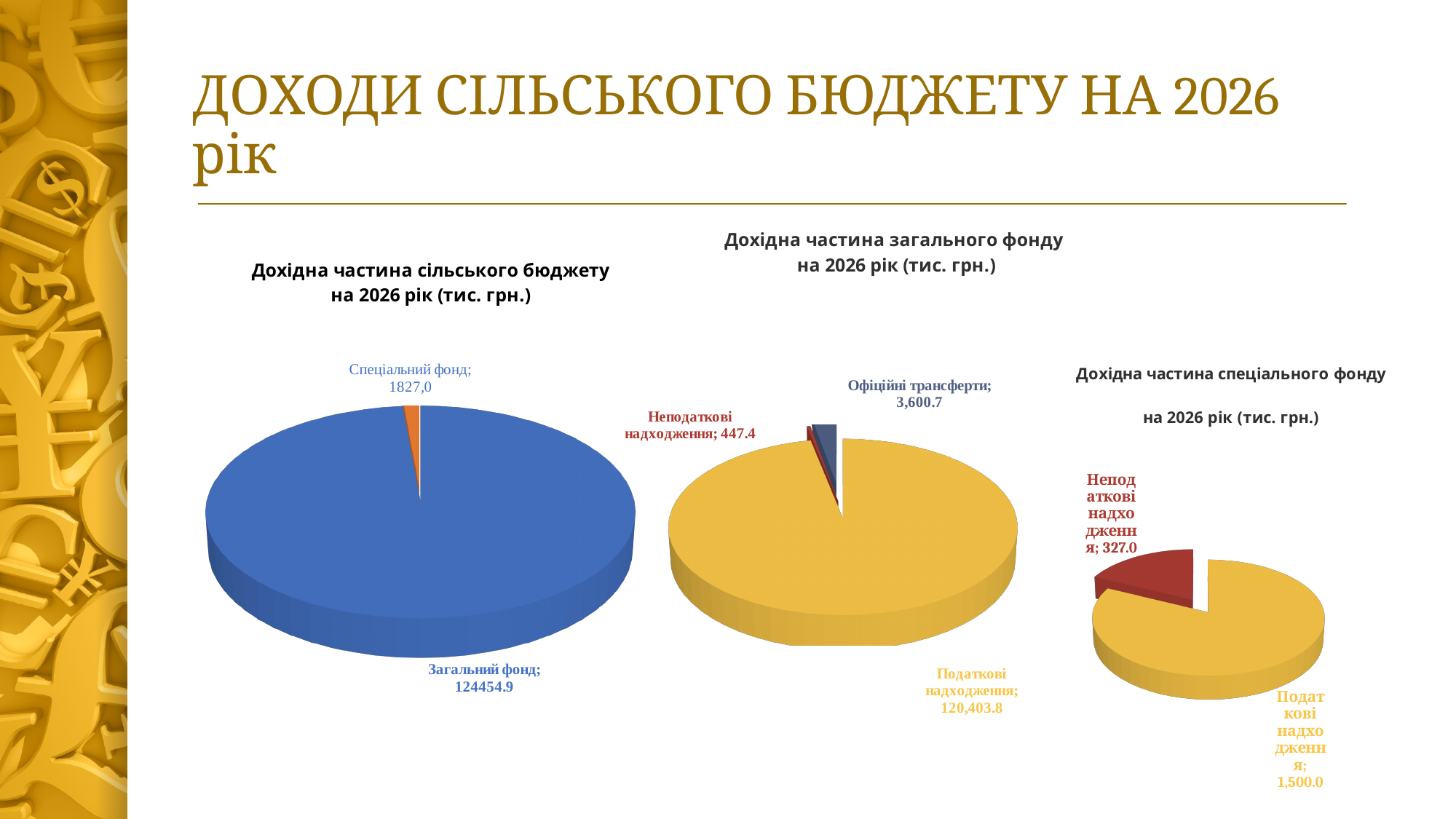
In the chart titled "Дохідна частина спеціального фонду на 2026 рік (тис. грн.)", what is the value for Податкові надходження? 1,500.0 In the chart titled "Дохідна частина загального фонду на 2026 рік (тис. грн.)", how many slices does the pie have? 3 In the chart titled "Дохідна частина сільського бюджету на 2026 рік (тис. грн.)", what is the value for Загальний фонд? 124454.9 In the chart titled "Дохідна частина загального фонду на 2026 рік (тис. грн.)", what is the value for Офіційні трансферти? 3,600.7 In the chart titled "Дохідна частина спеціального фонду на 2026 рік (тис. грн.)", which is larger: Податкові надходження or Неподаткові надходження? Податкові надходження In the chart titled "Дохідна частина загального фонду на 2026 рік (тис. грн.)", which category has the largest slice? Податкові надходження How many charts are shown on the slide? 3 What kind of chart is the leftmost chart on the slide? Pie chart In the chart titled "Дохідна частина загального фонду на 2026 рік (тис. грн.)", what is the value for Неподаткові надходження? 447.4 In the chart titled "Дохідна частина сільського бюджету на 2026 рік (тис. грн.)", what is the value for Спеціальний фонд? 1827,0 In the chart titled "Дохідна частина спеціального фонду на 2026 рік (тис. грн.)", what is the difference between Податкові надходження and Неподаткові надходження? 1,173.0 In the chart titled "Дохідна частина загального фонду на 2026 рік (тис. грн.)", which category has the smallest slice? Неподаткові надходження